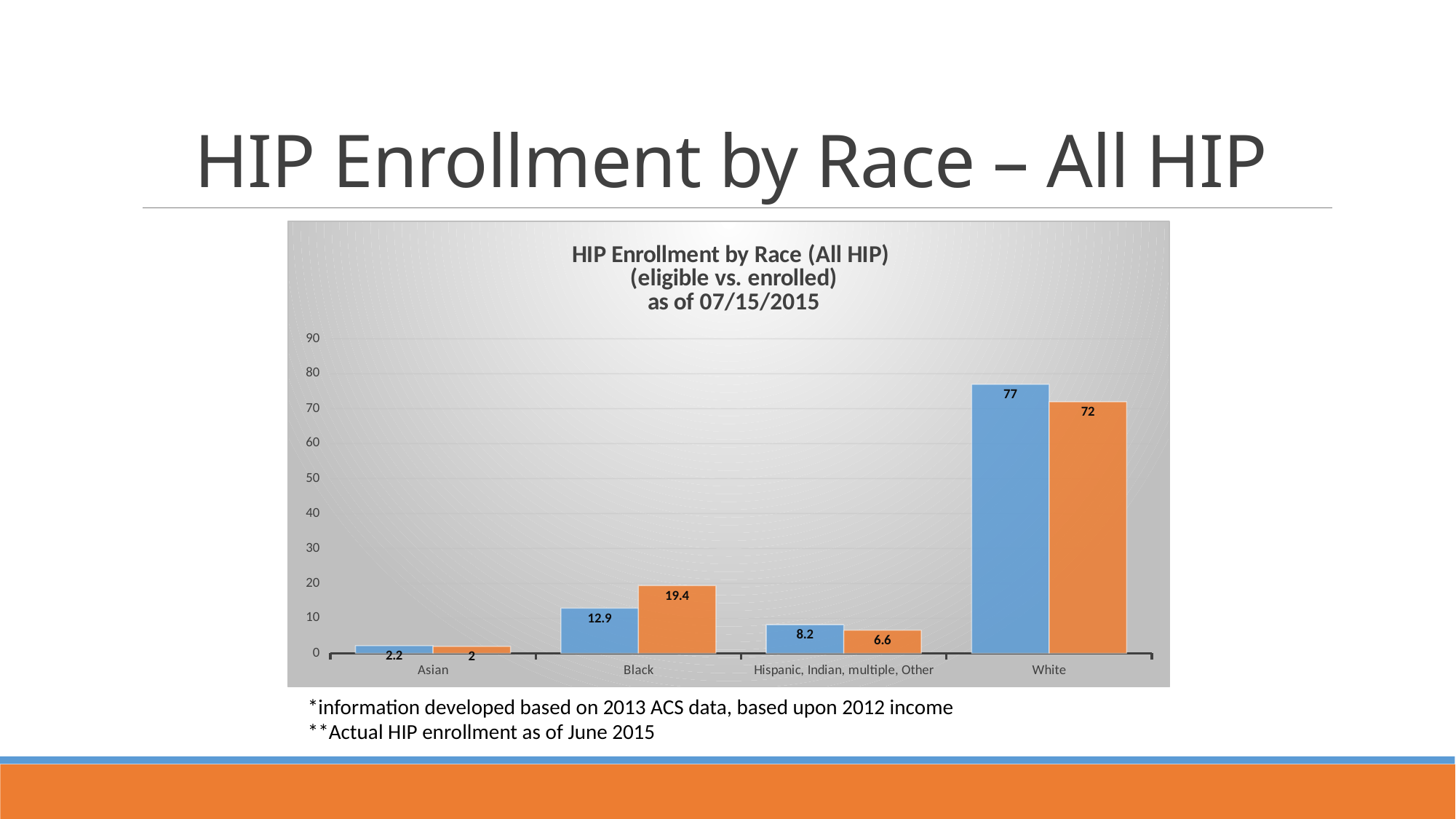
Which category has the lowest orange bar? Asian Is the blue bar for White greater or less than 70? greater What is the value of the blue bar for Black? 12.9 How many categories are shown on the x axis? 4 What is the difference between the orange and blue bars for Black? 6.5 What is the difference between the blue and orange bars for White? 5 Which category has the highest blue bar? White What is the value of the blue bar for Hispanic, Indian, multiple, Other? 8.2 For Black, which bar is larger, the blue or the orange? orange What kind of chart is shown on the slide? bar chart What is the value of the orange bar for White? 72 What is the value of the orange bar for Asian? 2